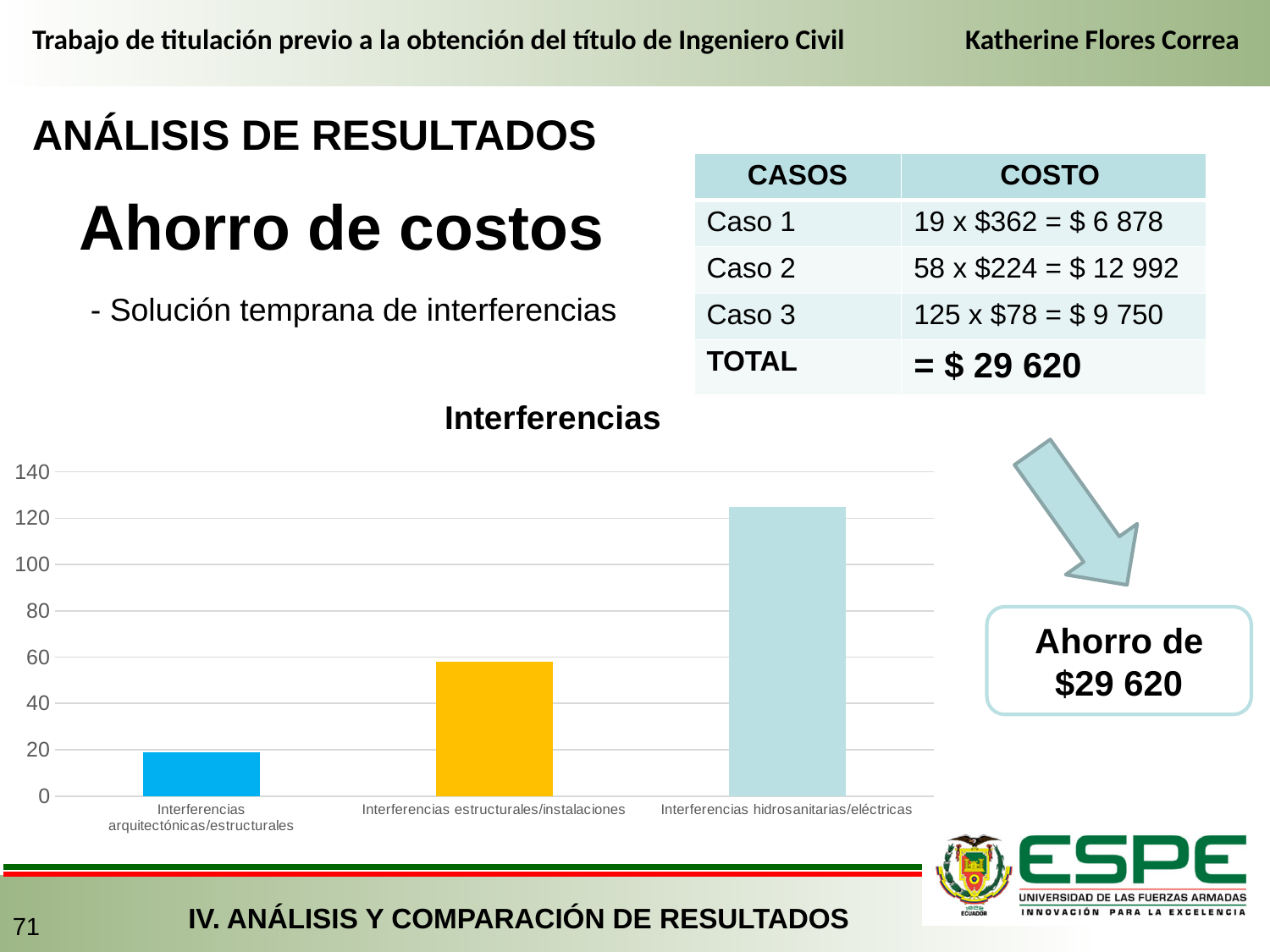
Is the value for Interferencias arquitectónicas/estructurales greater or less than 40? less What is the highest value shown on the vertical axis of the chart? 140 Which category has the highest value in the chart? Interferencias hidrosanitarias/eléctricas Which category has the lowest value in the chart? Interferencias arquitectónicas/estructurales Do the bar values rise or fall from left to right across the categories? rise Which is larger: the value for Interferencias estructurales/instalaciones or for Interferencias arquitectónicas/estructurales? Interferencias estructurales/instalaciones What kind of chart is shown on the slide? bar chart What is the title of the chart? Interferencias Is the value for Interferencias estructurales/instalaciones greater or less than 80? less How many categories are plotted in the chart? 3 Is the value for Interferencias hidrosanitarias/eléctricas greater or less than 100? greater